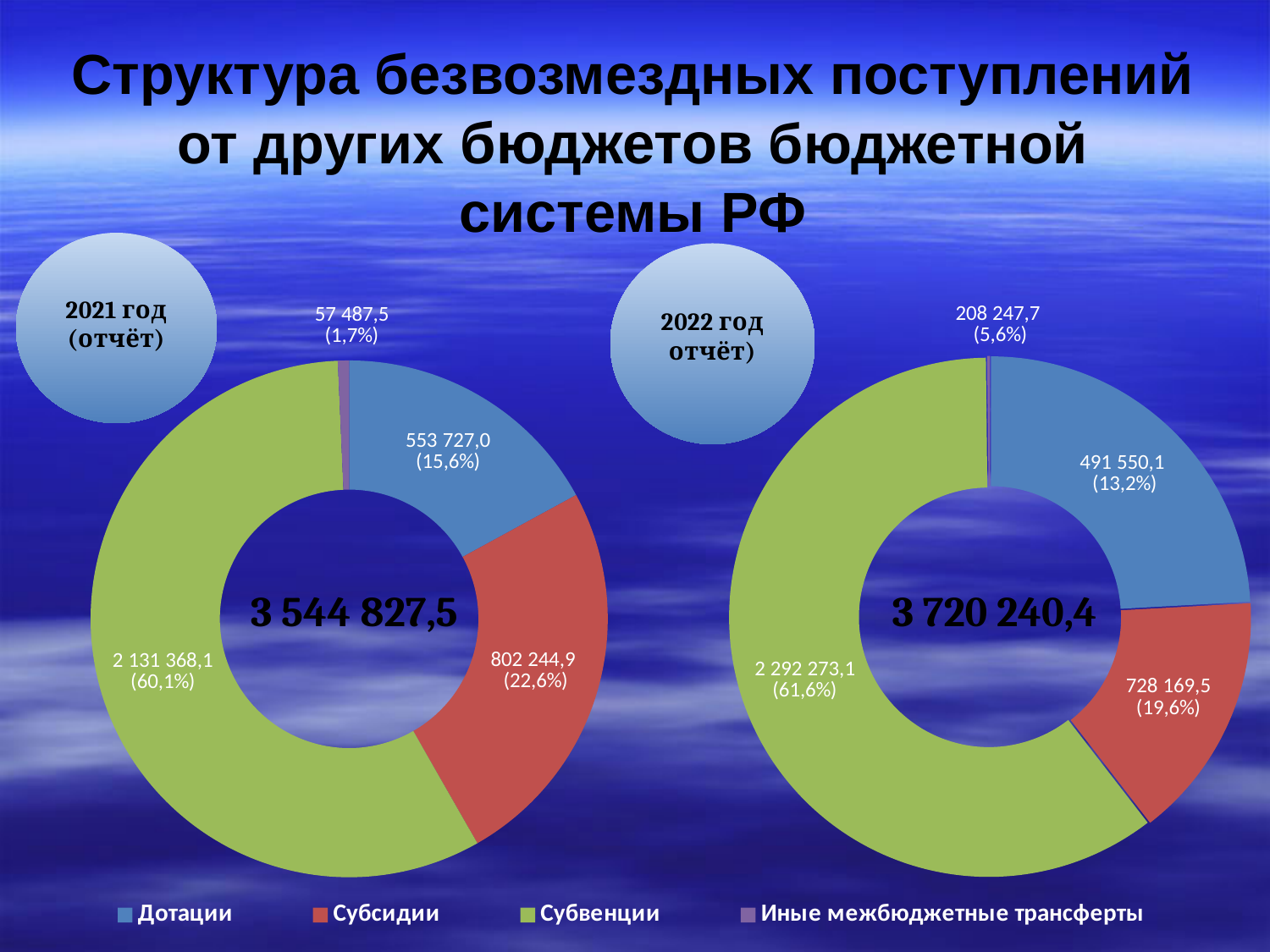
On the 2022 год (отчёт) chart, what share of the total does Иные межбюджетные трансферты represent? 5,6% On the 2022 год (отчёт) chart, what is the total shown in the centre of the doughnut? 3 720 240,4 On the 2021 год (отчёт) chart, what is the value for Субсидии? 802 244,9 What type of chart is used on the slide for the 2021 год (отчёт) data? Doughnut (pie) chart On the 2021 год (отчёт) chart, what is the total shown in the centre of the doughnut? 3 544 827,5 Which is larger: Субсидии on the 2021 год (отчёт) chart or Субсидии on the 2022 год (отчёт) chart? 2021 год (отчёт) What is the difference between the Субвенции values on the 2022 год (отчёт) chart and the 2021 год (отчёт) chart? 160 905,0 On the 2021 год (отчёт) chart, which category has the largest value? Субвенции On the 2022 год (отчёт) chart, which category has the smallest value? Иные межбюджетные трансферты On the 2022 год (отчёт) chart, what is the value for Дотации? 491 550,1 On the 2021 год (отчёт) chart, what share of the total does Субвенции represent? 60,1% How many categories does the legend list for the charts? 4